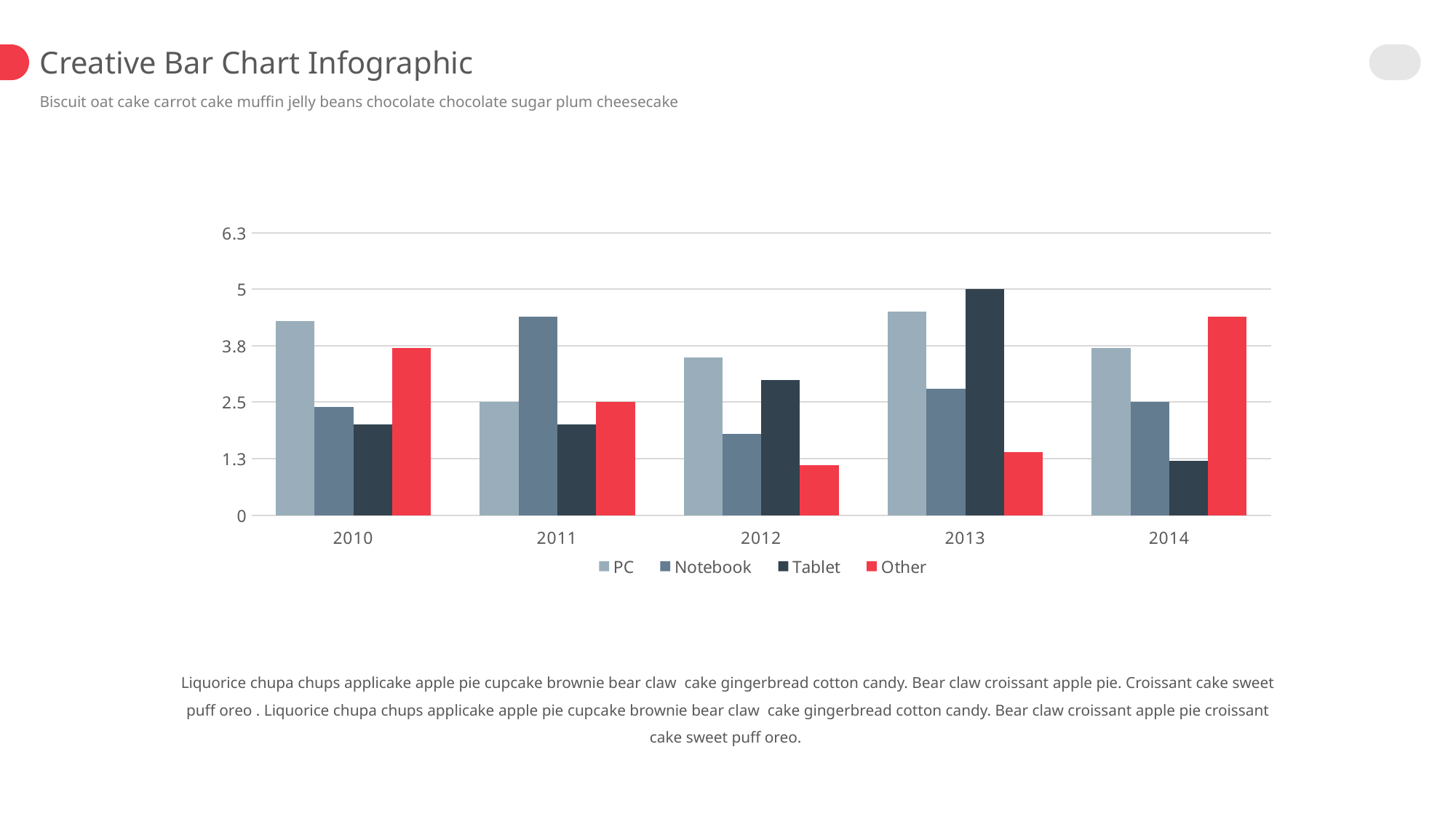
Is the value for Notebook in 2012 greater or less than 2.5? less Is the value for Other in 2012 greater or less than 1.3? less Which series has the tallest bar in 2013? Tablet Which is larger in 2013, PC or Notebook? PC Which legend entry is shown in red? Other Is the value for PC in 2010 greater or less than 3.8? greater In which year is the PC series lowest? 2011 In which year is the Other series highest? 2014 What is the value for Tablet in 2013? 5 What kind of chart is shown on the slide? bar chart How many years are shown on the x axis? 5 How many series does the legend list? 4